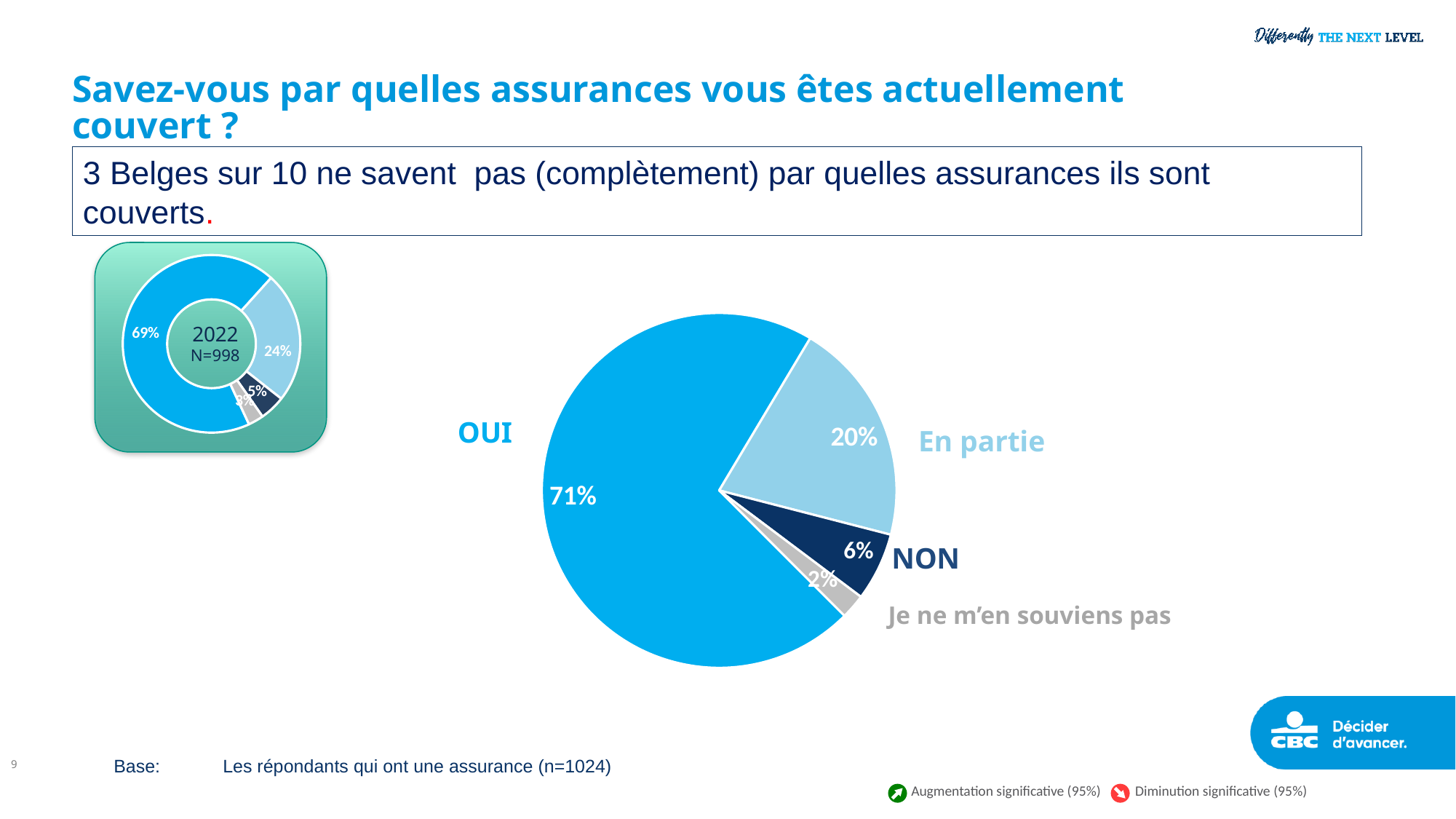
On the large pie chart, what percentage of respondents answered Je ne m'en souviens pas? 2% On the large pie chart, what percentage of respondents answered En partie? 20% On the small donut chart on the left, what year and sample size are shown in the centre? 2022, N=998 What kind of chart is the large chart in the centre of the slide? Pie chart On the large pie chart, which answer has the largest share? OUI On the large pie chart, what percentage of respondents answered OUI? 71% On the large pie chart, what is the difference in percentage points between OUI and En partie? 51 How many slices does the large pie chart have? 4 On the large pie chart, which answer has the smallest share? Je ne m'en souviens pas On the large pie chart, what percentage of respondents answered NON? 6% On the small donut chart on the left, what is the largest percentage shown? 69% On the large pie chart, which is larger, the share for NON or the share for En partie? En partie